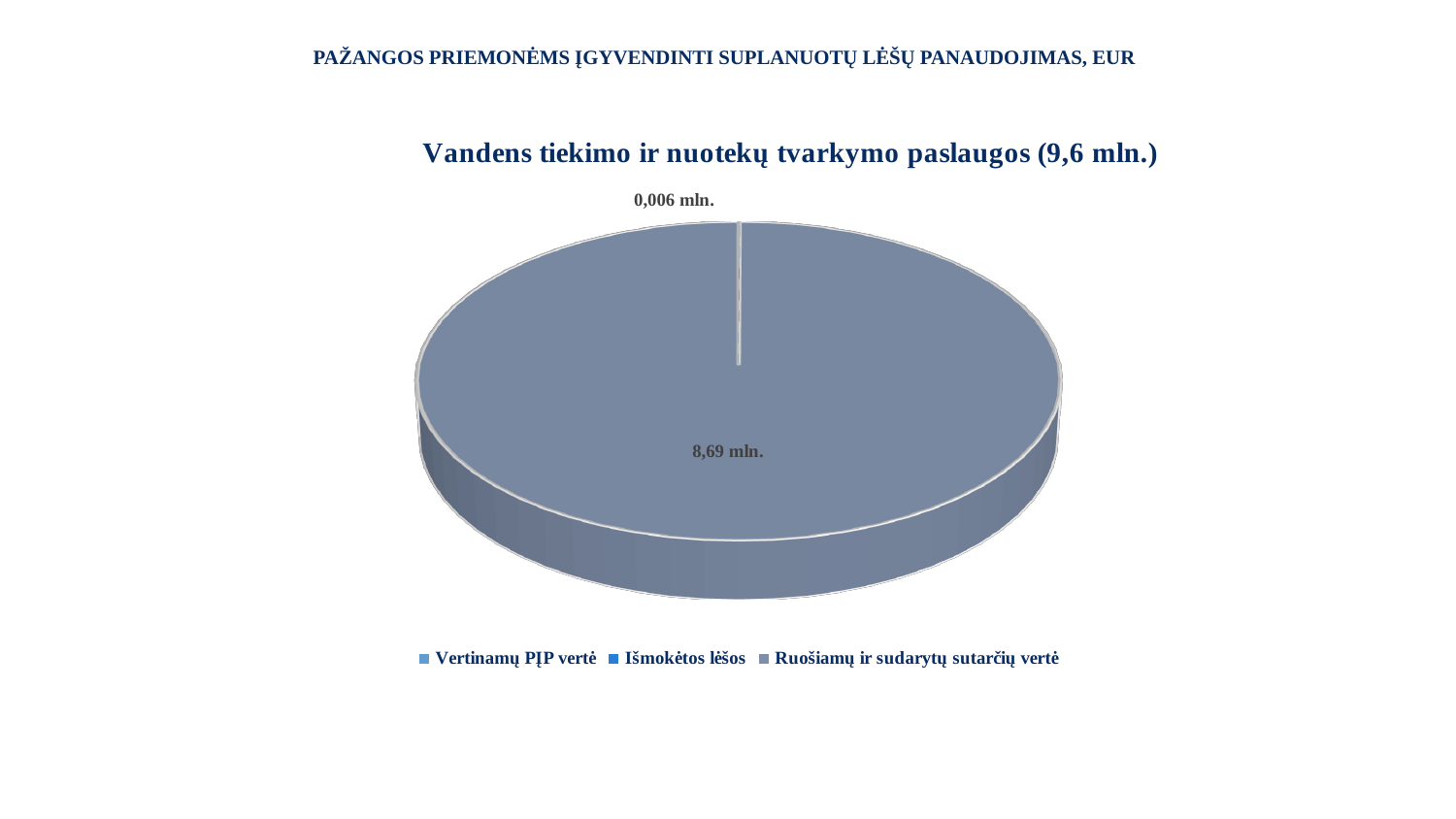
What kind of chart is shown on the slide? pie chart What total amount is given in parentheses in the chart title? 9,6 mln. What value is labelled on the largest slice of the pie? 8,69 mln. Which labelled value is larger, 8,69 mln. or 0,006 mln.? 8,69 mln. How many data labels are printed on the pie chart? 2 What is the difference between the two labelled values, 8,69 mln. and 0,006 mln.? 8,684 mln. What value is labelled on the thin slice at the top of the pie? 0,006 mln. What is the third entry listed in the chart legend? Ruošiamų ir sudarytų sutarčių vertė How many entries does the chart legend list? 3 What is the smallest value labelled on the pie chart? 0,006 mln. What is the title of the chart? Vandens tiekimo ir nuotekų tvarkymo paslaugos (9,6 mln.)